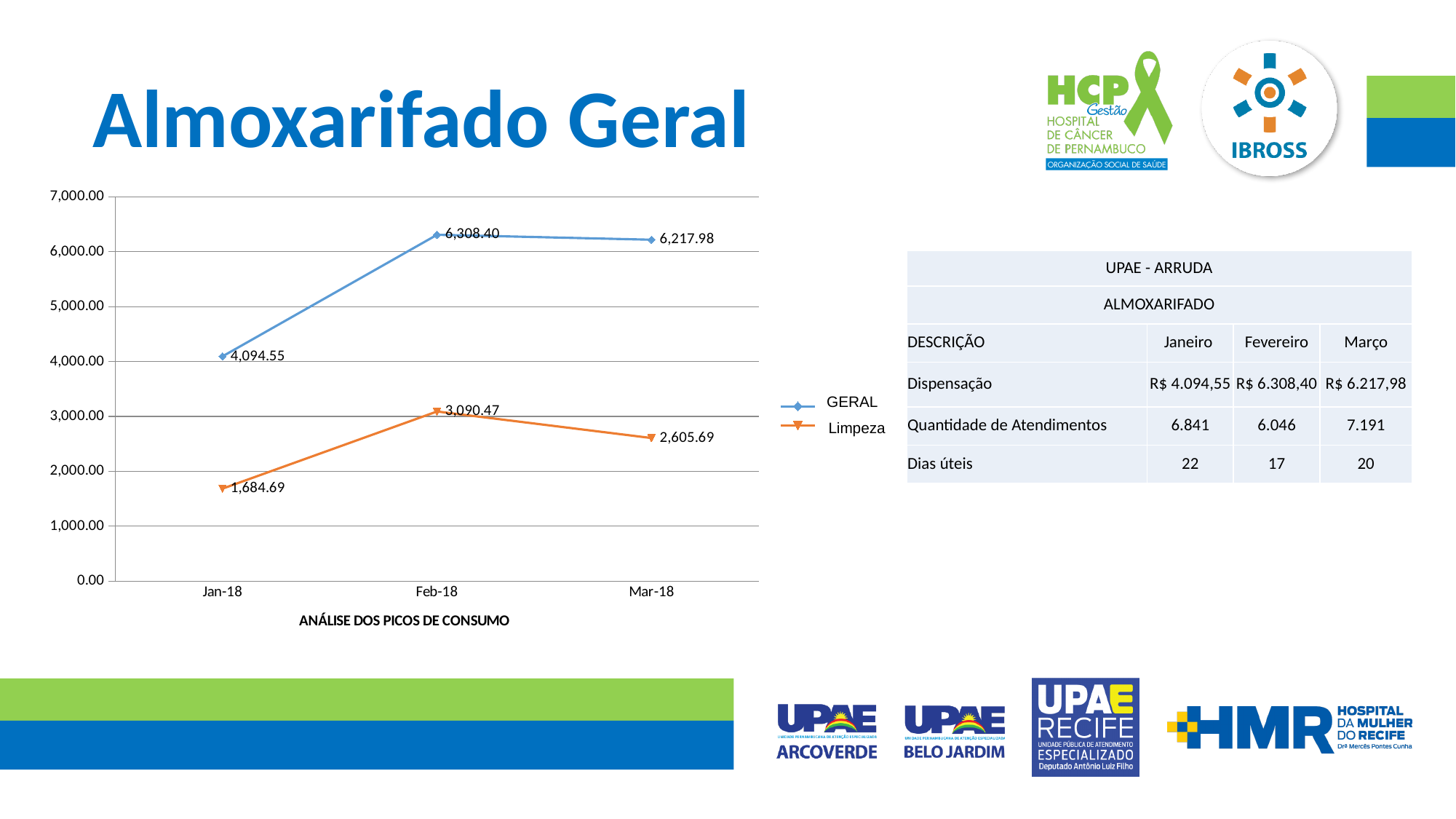
How many months are shown on the x axis? 3 What type of chart is shown on the slide? Line chart What is the Limpeza value for Jan-18? 1,684.69 What is the Limpeza value for Mar-18? 2,605.69 Which is larger in Mar-18, the GERAL value or the Limpeza value? GERAL In which month does the GERAL series reach its highest value? Feb-18 How many series does the legend list? 2 By how much did the GERAL value increase from Jan-18 to Feb-18? 2,213.85 In which month is the Limpeza series lowest? Jan-18 What is the difference between the GERAL and Limpeza values in Feb-18? 3,217.93 What is the GERAL value for Feb-18? 6,308.40 What is the GERAL value for Mar-18? 6,217.98